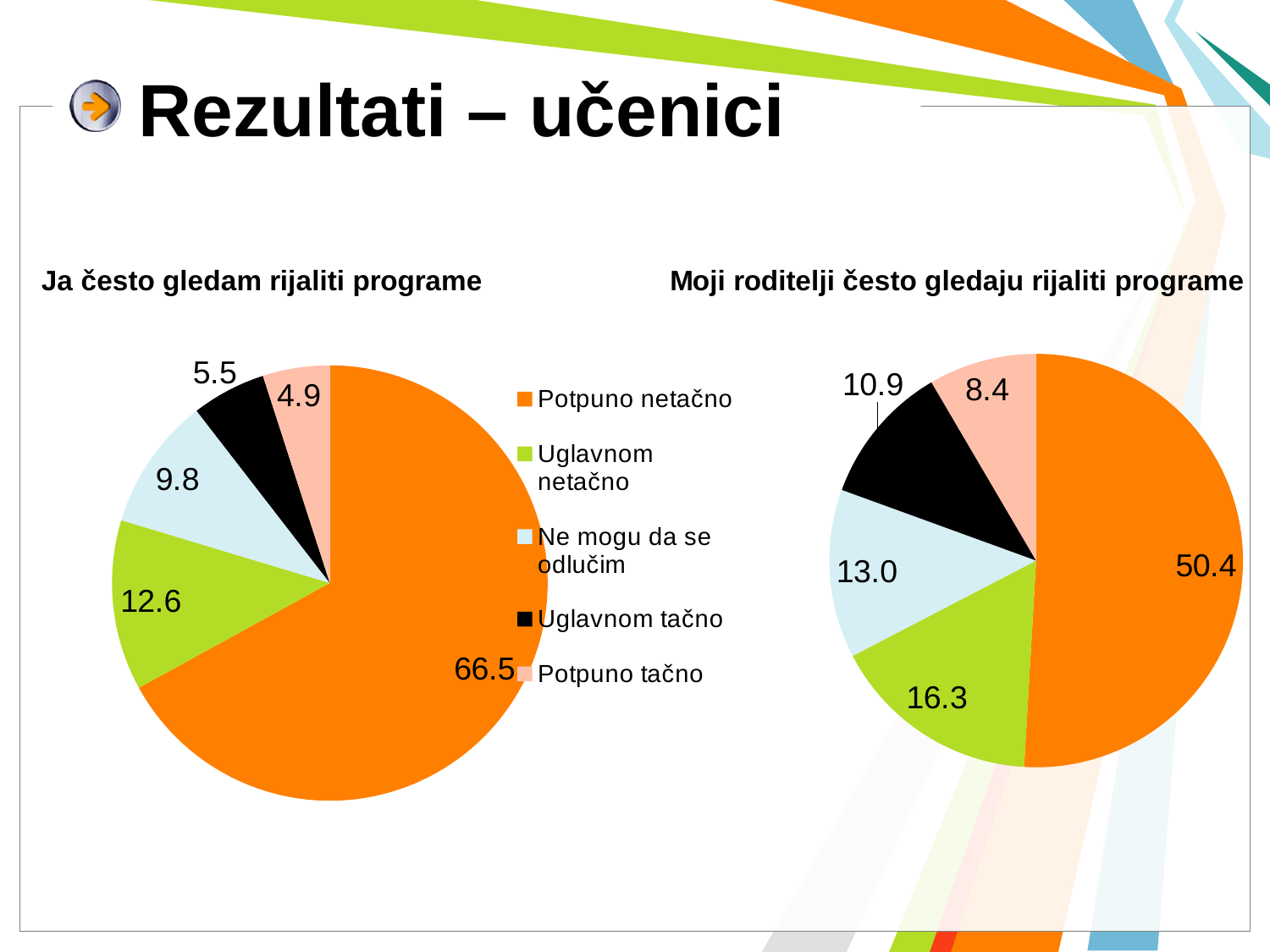
In the chart titled "Ja često gledam rijaliti programe", which category has the smallest slice? Potpuno tačno In the chart titled "Moji roditelji često gledaju rijaliti programe", what is the difference between the values for Potpuno netačno and Ne mogu da se odlučim? 37.4 In the chart titled "Ja često gledam rijaliti programe", what is the value for Ne mogu da se odlučim? 9.8 Which is larger: the value for Uglavnom tačno in the left chart or the value for Uglavnom tačno in the right chart? The right chart (10.9) What type of chart is used for "Moji roditelji često gledaju rijaliti programe"? Pie chart What colour represents Ne mogu da se odlučim in the legend? Light blue In the chart titled "Moji roditelji često gledaju rijaliti programe", what is the value for Potpuno tačno? 8.4 In the chart titled "Moji roditelji često gledaju rijaliti programe", which category has the largest slice? Potpuno netačno In the chart titled "Moji roditelji često gledaju rijaliti programe", what is the value for Uglavnom netačno? 16.3 In the chart titled "Ja često gledam rijaliti programe", what is the difference between the values for Uglavnom netačno and Uglavnom tačno? 7.1 How many slices does the chart titled "Ja često gledam rijaliti programe" have? 5 In the chart titled "Ja često gledam rijaliti programe", what is the value for Potpuno netačno? 66.5